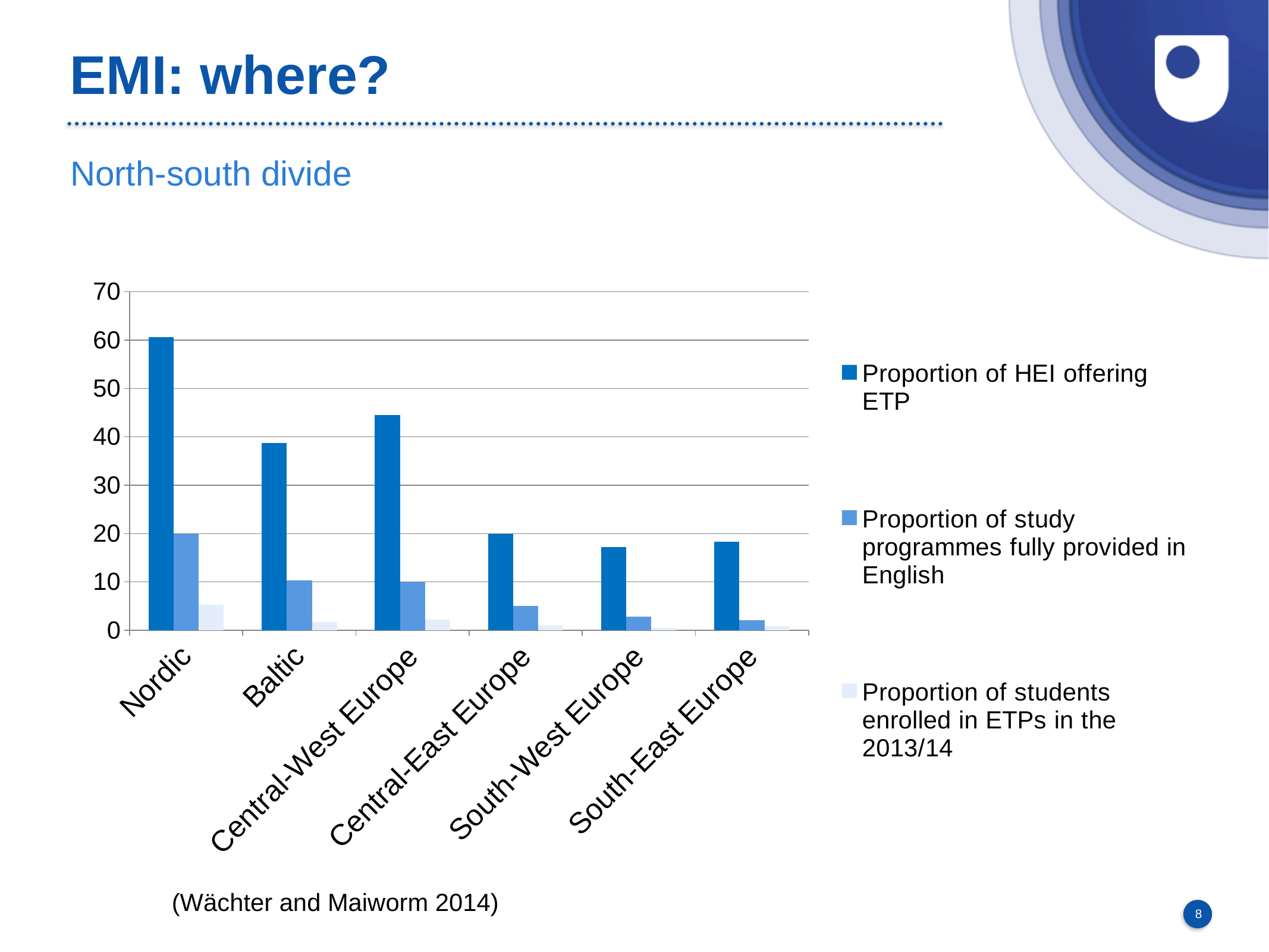
Which has the larger value for Proportion of HEI offering ETP, Baltic or Central-West Europe? Central-West Europe Is the value for Proportion of HEI offering ETP in Central-East Europe greater or less than 30? less Which has the larger value for Proportion of study programmes fully provided in English, Nordic or Baltic? Nordic How many series does the chart's legend list? 3 Is the value for Proportion of HEI offering ETP in Central-West Europe greater or less than 40? greater Which region has the highest value for Proportion of HEI offering ETP? Nordic What kind of chart is shown on the slide? Bar chart Which region has the highest value for Proportion of students enrolled in ETPs in the 2013/14? Nordic What source is cited below the chart? (Wächter and Maiworm 2014) Is the value for Proportion of HEI offering ETP in the Nordic region greater or less than 50? greater How many regions are shown on the x axis of the chart? 6